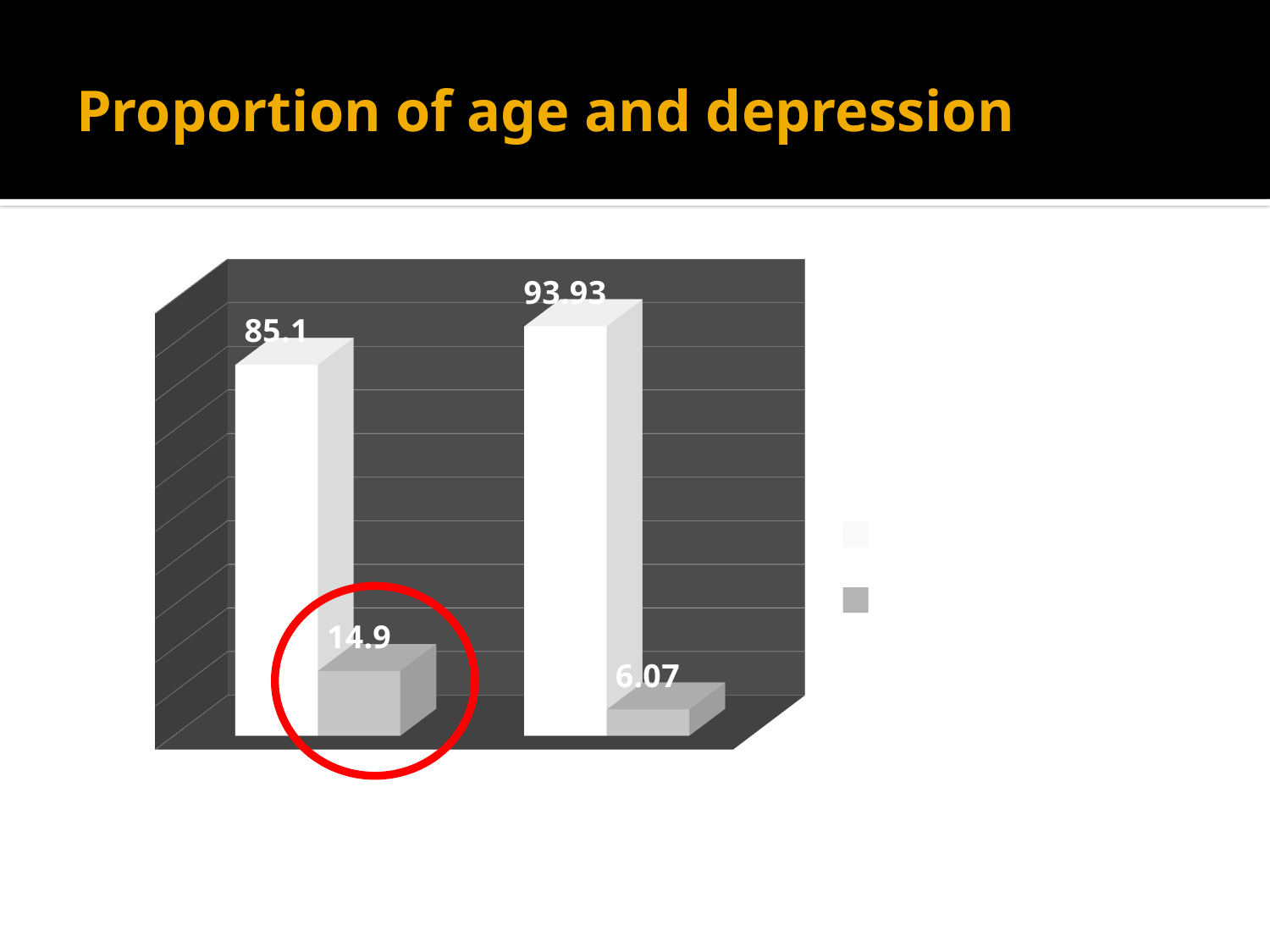
How many groups of bars are plotted in the chart? 2 What is the value of the white bar in the right group? 93.93 What is the difference between the white bar in the right group and the white bar in the left group? 8.83 Which grey bar is larger, the one in the left group or the one in the right group? left group What kind of chart is shown on the slide? bar chart What is the highest value shown in the chart? 93.93 What is the title of the slide above the chart? Proportion of age and depression What is the value of the grey bar in the left group? 14.9 What is the value of the grey bar in the right group? 6.07 What is the value of the white bar in the left group? 85.1 How many series does the legend show? 2 What is the lowest value shown in the chart? 6.07